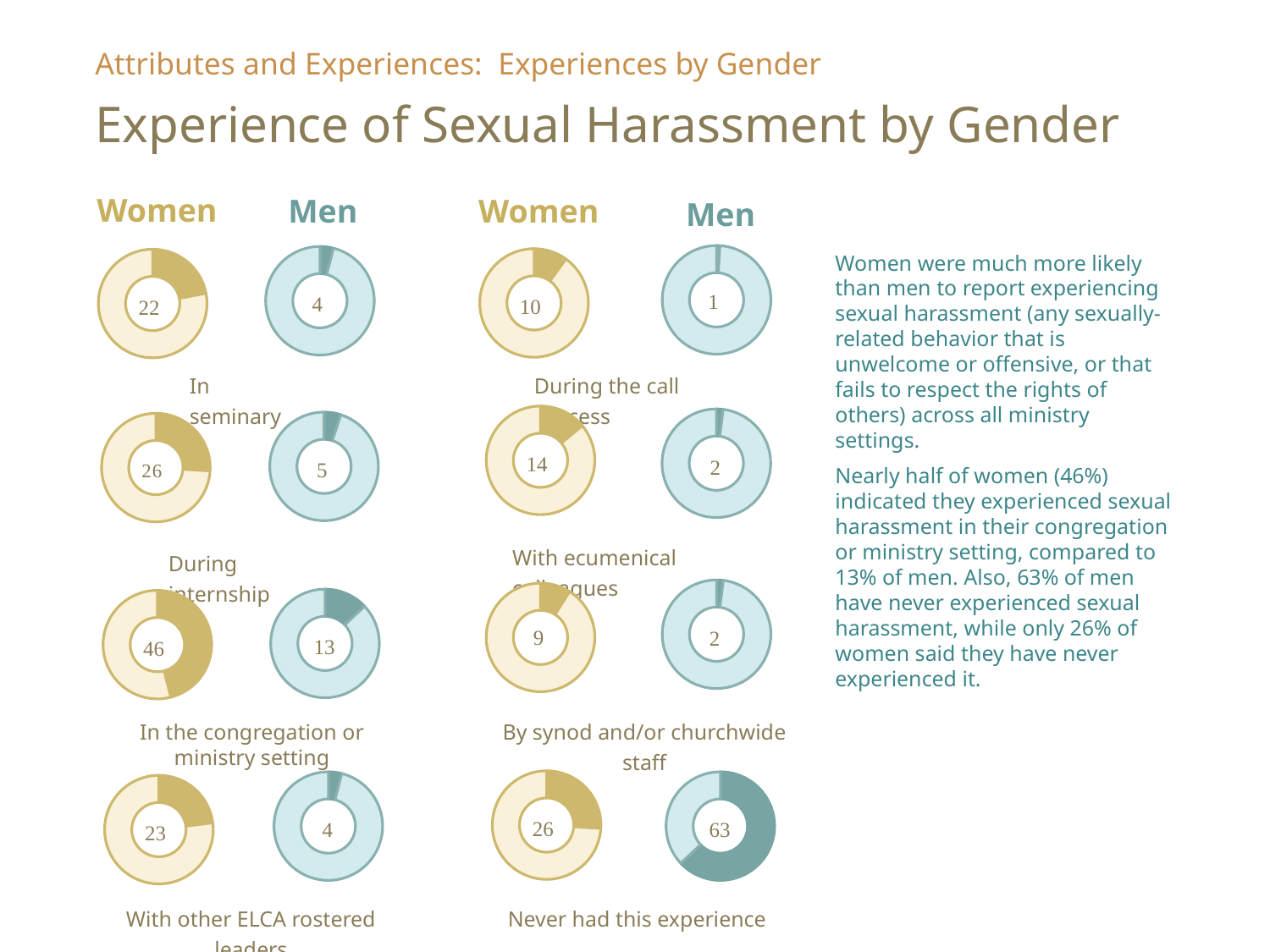
In the 'With ecumenical colleagues' charts, what is the difference between the Women and Men values? 12 In the 'In seminary' charts, what value is shown for Women? 22 Across all the Men charts on the slide, which setting has the lowest value? During the call process Across all the Women charts on the slide, which setting has the highest value? In the congregation or ministry setting In the 'In the congregation or ministry setting' charts, what value is shown for Women? 46 In the 'Never had this experience' charts, what value is shown for Men? 63 In the 'During internship' charts, which is larger, the Women value or the Men value? Women What kind of chart is used to show the values on this slide? Donut chart In the 'During the call process' charts, what value is shown for Men? 1 In the 'By synod and/or churchwide staff' charts, what is the difference between the Women and Men values? 7 In the 'In seminary' charts, what value is shown for Men? 4 In the 'Never had this experience' charts, which is larger, the Women value or the Men value? Men